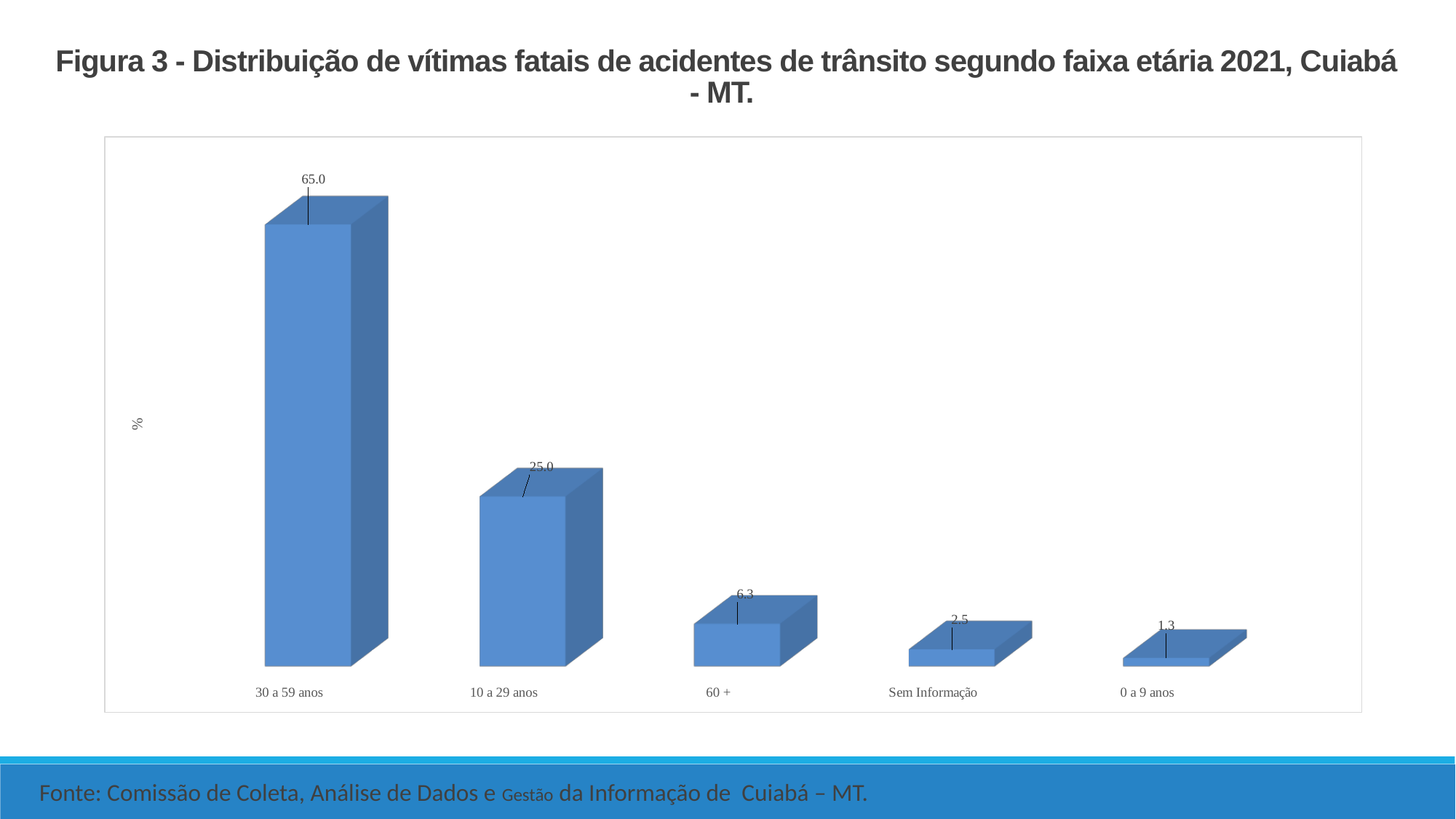
What kind of chart is shown on the slide? Bar chart What is the label on the vertical axis of the chart? % What is the value for 'Sem Informação'? 2.5 What is the value for the '0 a 9 anos' age group? 1.3 Which age group has the highest value? 30 a 59 anos Which is larger, the value for '60 +' or the value for 'Sem Informação'? 60 + What is the value for the '10 a 29 anos' age group? 25.0 What is the value for the '30 a 59 anos' age group? 65.0 What is the value for the '60 +' age group? 6.3 How many categories are shown on the x axis? 5 What is the difference between the values for '30 a 59 anos' and '10 a 29 anos'? 40.0 Which category has the lowest value? 0 a 9 anos